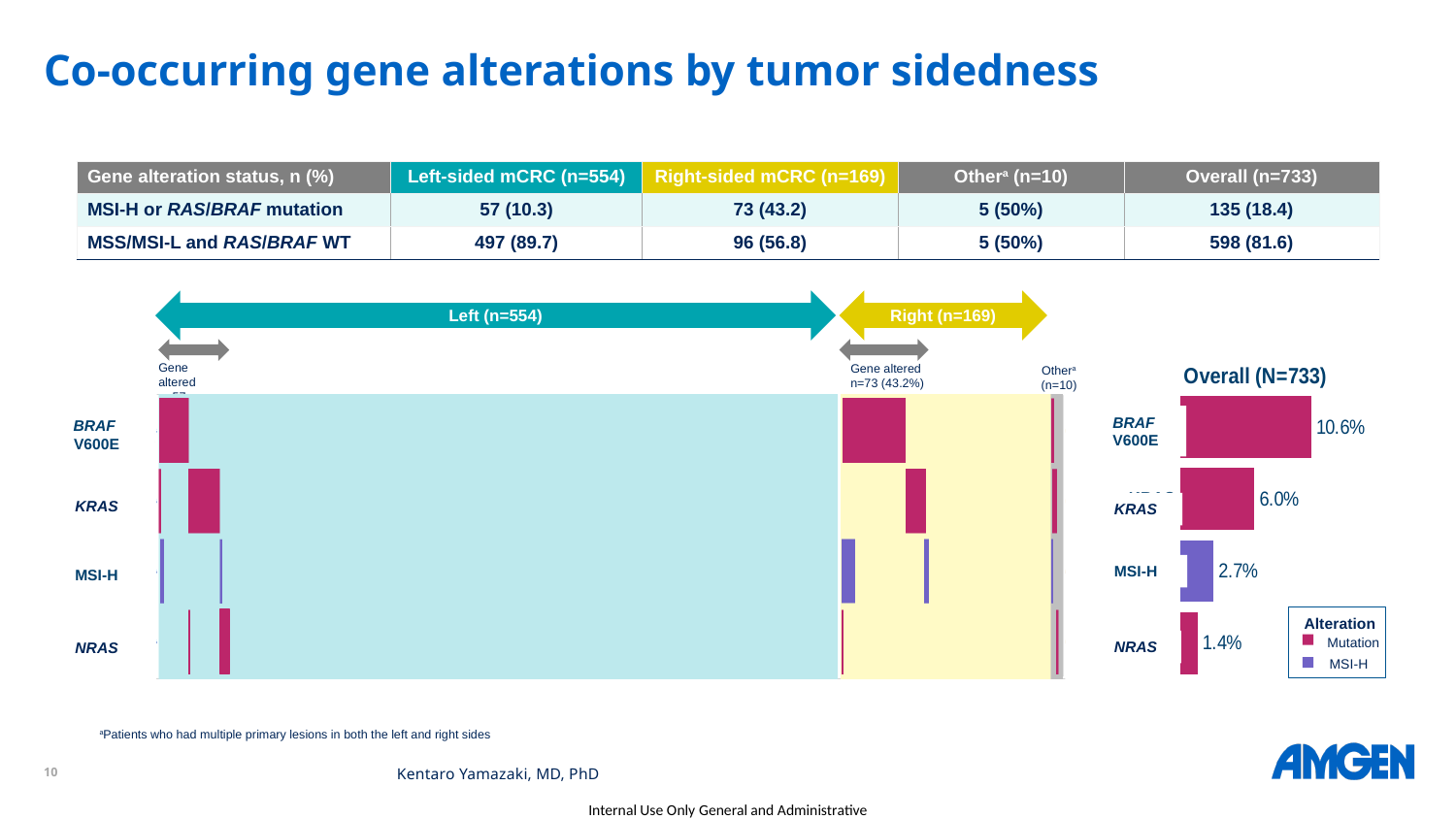
In the 'Overall (N=733)' bar chart, what is the value for NRAS? 1.4% In the 'Overall (N=733)' bar chart, which gene alteration has the highest value? BRAF V600E In the 'Overall (N=733)' bar chart, which is larger, the value for KRAS or the value for MSI-H? KRAS In the 'Overall (N=733)' bar chart, what is the value for MSI-H? 2.7% How many entries does the 'Alteration' legend list? 2 In the 'Overall (N=733)' bar chart, which gene alteration has the lowest value? NRAS In the 'Overall (N=733)' bar chart, what is the difference between the BRAF V600E and KRAS values? 4.6% How many gene alteration categories are shown in the 'Overall (N=733)' bar chart? 4 In the 'Overall (N=733)' bar chart, what is the value for BRAF V600E? 10.6% In the 'Overall (N=733)' bar chart, what is the value for KRAS? 6.0% What type of chart is the 'Overall (N=733)' chart on the right of the slide? Bar chart In the 'Overall (N=733)' bar chart, what is the difference between the MSI-H and NRAS values? 1.3%